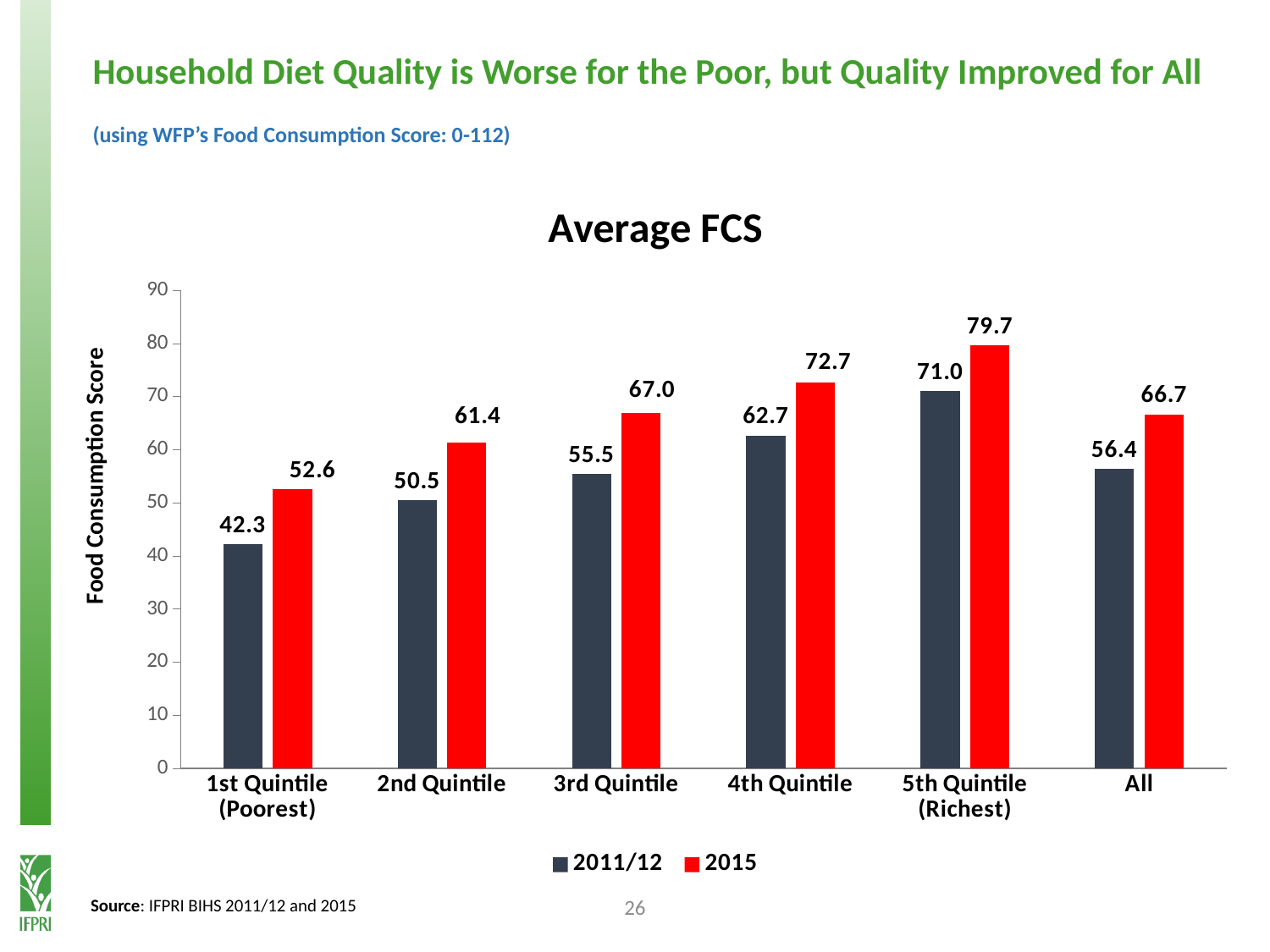
Which category has the lowest Average FCS in 2011/12? 1st Quintile (Poorest) What kind of chart is the Average FCS chart? bar chart What is the Average FCS for All households in 2015? 66.7 What is the difference between the 2015 and 2011/12 Average FCS for the 3rd Quintile? 11.5 Do the 2015 values rise or fall from the 1st Quintile to the 5th Quintile? rise Which category has the highest Average FCS in 2015? 5th Quintile (Richest) Is the 2011/12 value for the 5th Quintile (Richest) greater or less than 70? greater What is the Average FCS for the 1st Quintile (Poorest) in 2011/12? 42.3 Which is larger: the 2015 value for the 2nd Quintile or the 2011/12 value for the 4th Quintile? 2011/12 value for the 4th Quintile What is the Average FCS for the 5th Quintile (Richest) in 2015? 79.7 How many categories are shown on the x axis of the Average FCS chart? 6 How many series does the legend list? 2